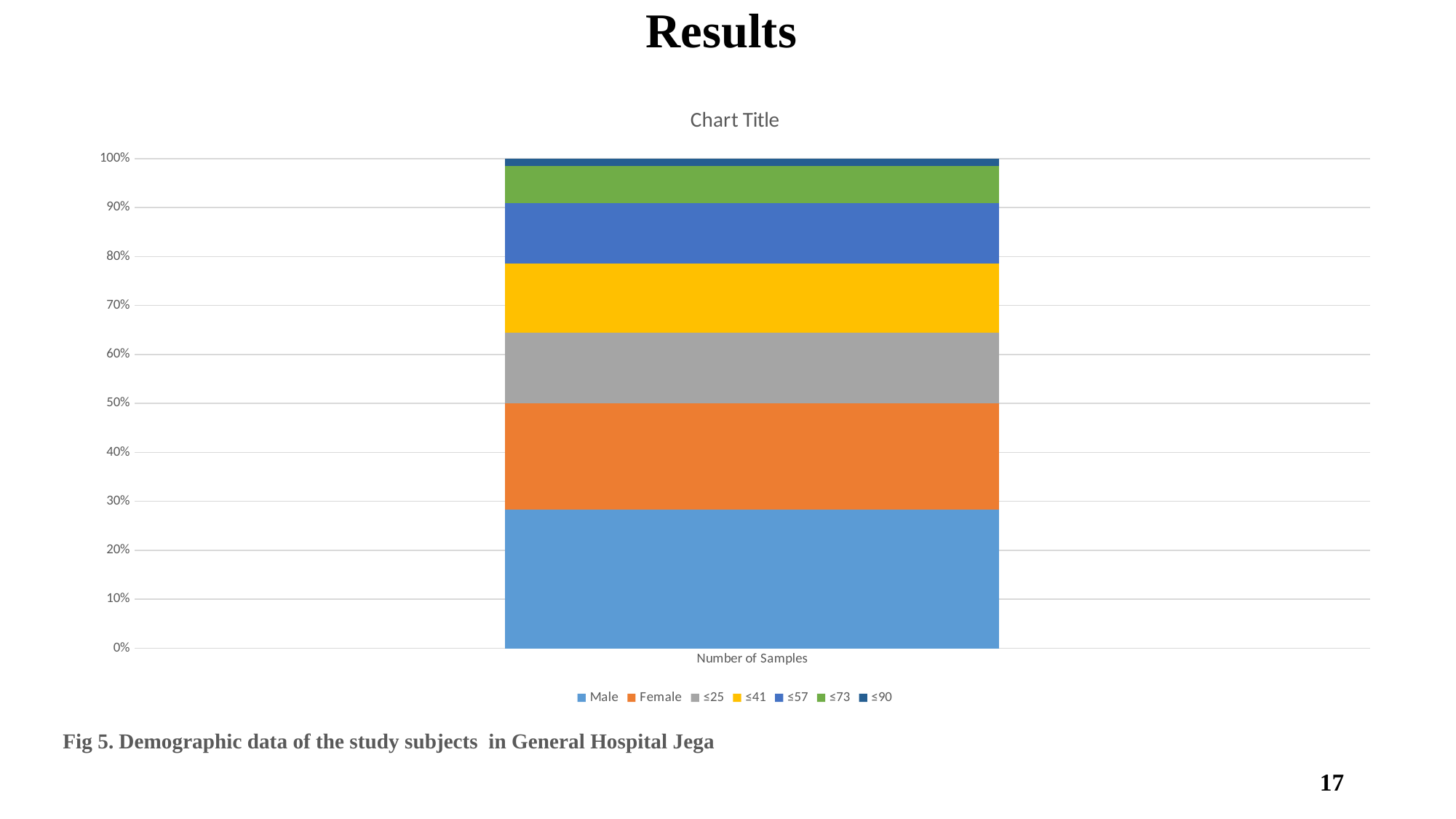
Which segment is larger in the stacked bar, Female or ≤25? Female What is the label of the single category on the x axis? Number of Samples What is the title shown above the chart? Chart Title Is the share for Male greater or less than 20%? greater What kind of chart is shown on the slide? Stacked bar chart Which series takes up the smallest share of the stacked bar? ≤90 Which series takes up the largest share of the stacked bar? Male Is the share for Male greater or less than 30%? less Is the share for ≤73 greater or less than 10%? less Which segment is larger in the stacked bar, Male or Female? Male How many categories are plotted on the x axis? 1 How many series does the legend list? 7